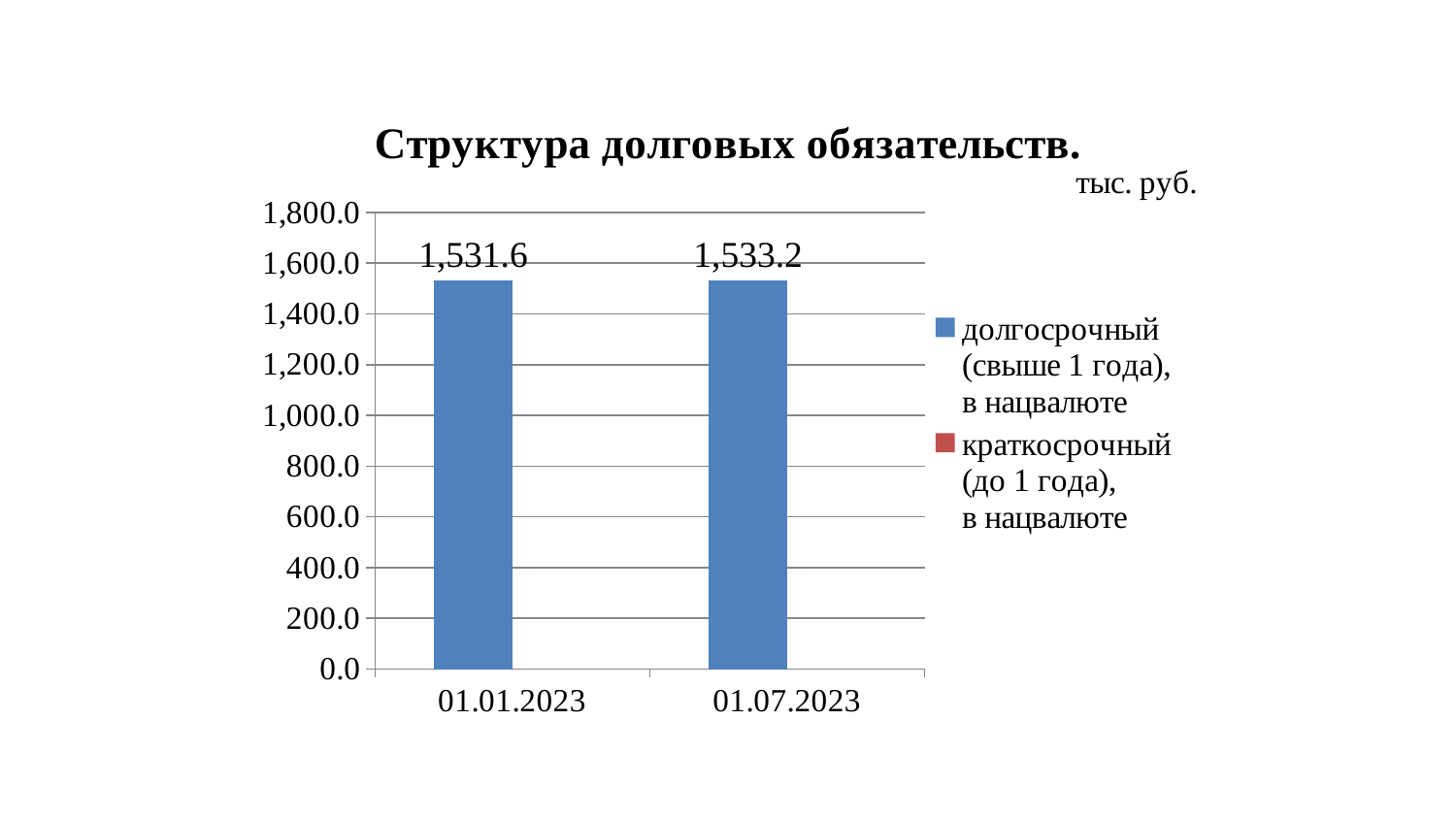
How many series does the legend list? 2 Is the value for 01.01.2023 greater or less than 1,400.0? greater How many dates are shown on the x axis? 2 Do the долгосрочный values rise or fall from 01.01.2023 to 01.07.2023? rise What is the value for долгосрочный (свыше 1 года), в нацвалюте on 01.07.2023? 1,533.2 What kind of chart is shown on the slide? bar chart What is the title of the chart? Структура долговых обязательств. What is the difference between the долгосрочный values on 01.07.2023 and 01.01.2023? 1.6 What unit is indicated next to the chart title? тыс. руб. What is the value for долгосрочный (свыше 1 года), в нацвалюте on 01.01.2023? 1,531.6 According to the data labels, which date has the larger долгосрочный value, 01.01.2023 or 01.07.2023? 01.07.2023 Is the value for 01.07.2023 greater or less than 1,600.0? less